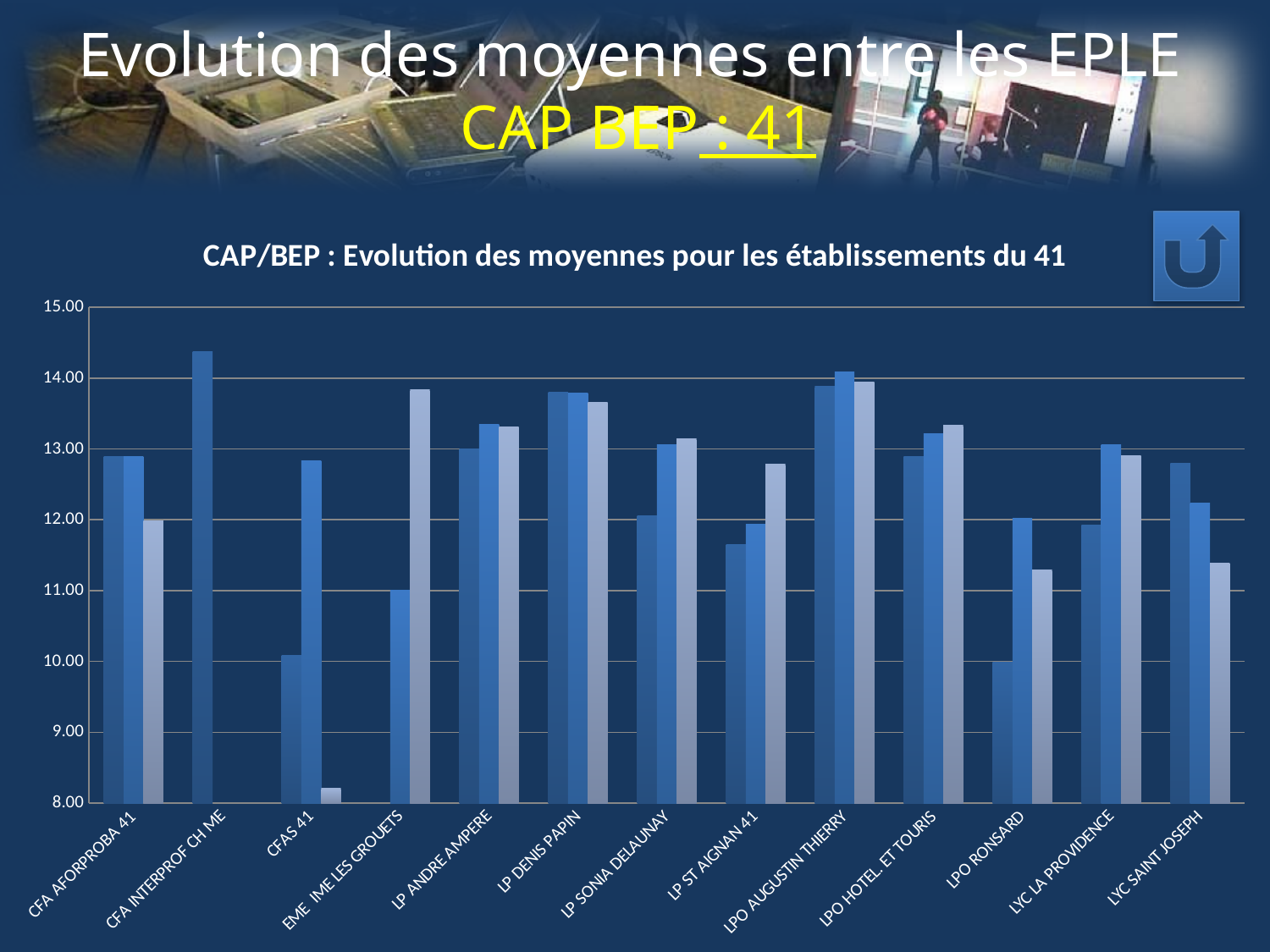
Which establishment has the lowest bar in the chart? CFAS 41 What is the title of the chart? CAP/BEP : Evolution des moyennes pour les établissements du 41 Is the value of the third (lightest) bar for CFAS 41 greater or less than 9.00? less What kind of chart is shown on the slide? Bar chart Is the value of the first (darkest) bar for LPO AUGUSTIN THIERRY greater or less than 13.00? greater Is the value of the third (lightest) bar for LPO RONSARD greater or less than 12.00? less What are the minimum and maximum values shown on the chart's vertical axis? 8.00 and 15.00 How many establishments (categories) are shown on the x axis of the chart? 13 Which is larger: the first (darkest) bar for CFA AFORPROBA 41 or the first (darkest) bar for LP ST AIGNAN 41? CFA AFORPROBA 41